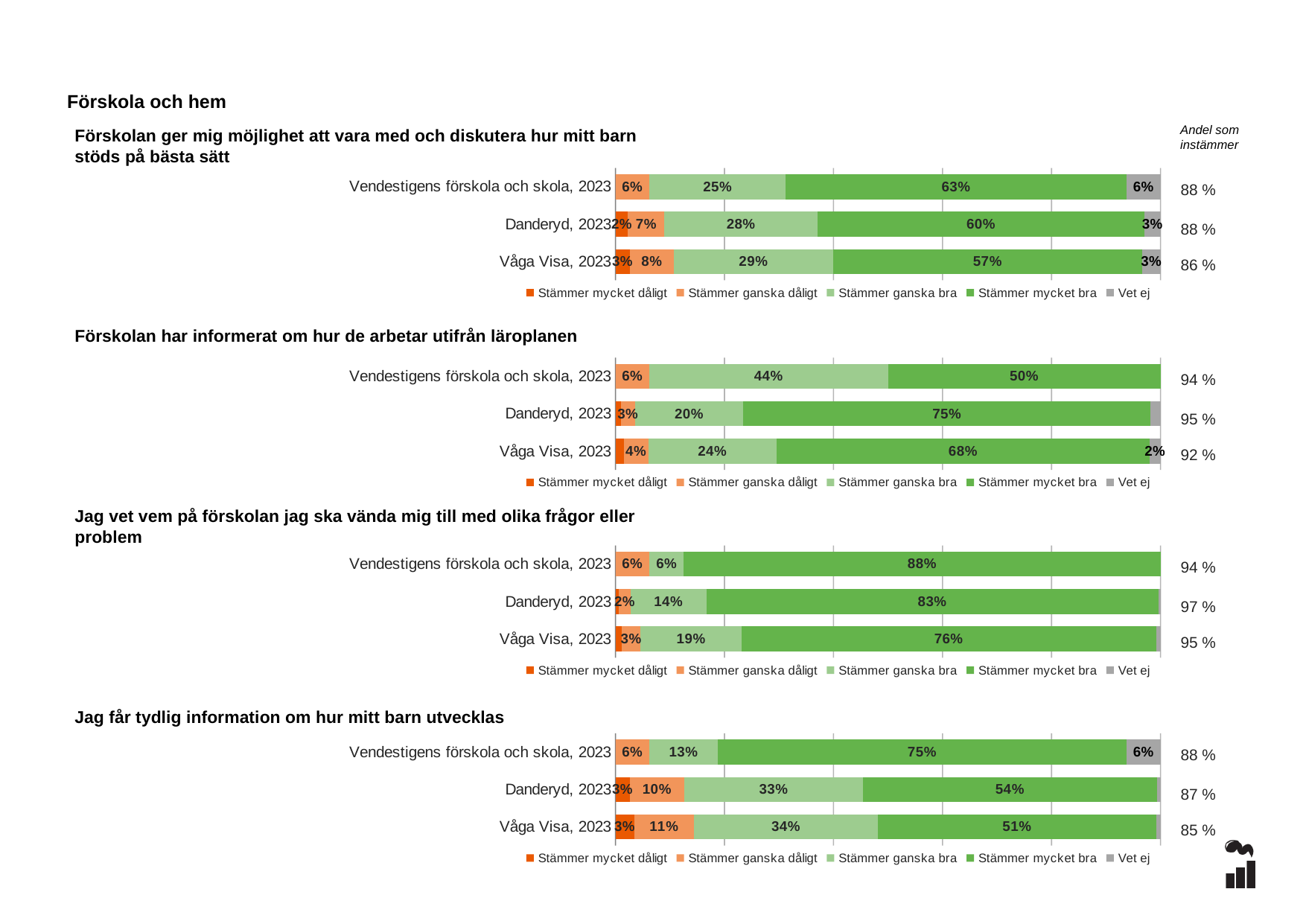
In the chart 'Jag vet vem på förskolan jag ska vända mig till med olika frågor eller problem', which is larger: the 'Stämmer ganska bra' value for Danderyd, 2023 or for Våga Visa, 2023? Våga Visa, 2023 In the chart 'Jag vet vem på förskolan jag ska vända mig till med olika frågor eller problem', what is the 'Stämmer mycket bra' value for Vendestigens förskola och skola, 2023? 88% In the chart 'Jag får tydlig information om hur mitt barn utvecklas', what is the 'Stämmer mycket bra' value for Danderyd, 2023? 54% How many categories (bars) are shown in the chart 'Förskolan har informerat om hur de arbetar utifrån läroplanen'? 3 In the chart 'Jag får tydlig information om hur mitt barn utvecklas', which category has the lowest 'Stämmer mycket bra' value? Våga Visa, 2023 How many series does the legend list for the chart 'Jag får tydlig information om hur mitt barn utvecklas'? 5 In the chart 'Jag får tydlig information om hur mitt barn utvecklas', what is the difference between the 'Stämmer mycket bra' values for Vendestigens förskola och skola, 2023 and Våga Visa, 2023? 24% What kind of chart is used for 'Förskolan ger mig möjlighet att vara med och diskutera hur mitt barn stöds på bästa sätt'? Stacked bar chart In the chart 'Förskolan ger mig möjlighet att vara med och diskutera hur mitt barn stöds på bästa sätt', what is the 'Stämmer ganska bra' value for Våga Visa, 2023? 29% In the chart 'Förskolan ger mig möjlighet att vara med och diskutera hur mitt barn stöds på bästa sätt', what is the 'Stämmer mycket bra' value for Vendestigens förskola och skola, 2023? 63% In the chart 'Förskolan har informerat om hur de arbetar utifrån läroplanen', what is the difference between the 'Stämmer ganska bra' values for Vendestigens förskola och skola, 2023 and Danderyd, 2023? 24% In the chart 'Förskolan har informerat om hur de arbetar utifrån läroplanen', which category has the highest 'Stämmer mycket bra' value? Danderyd, 2023